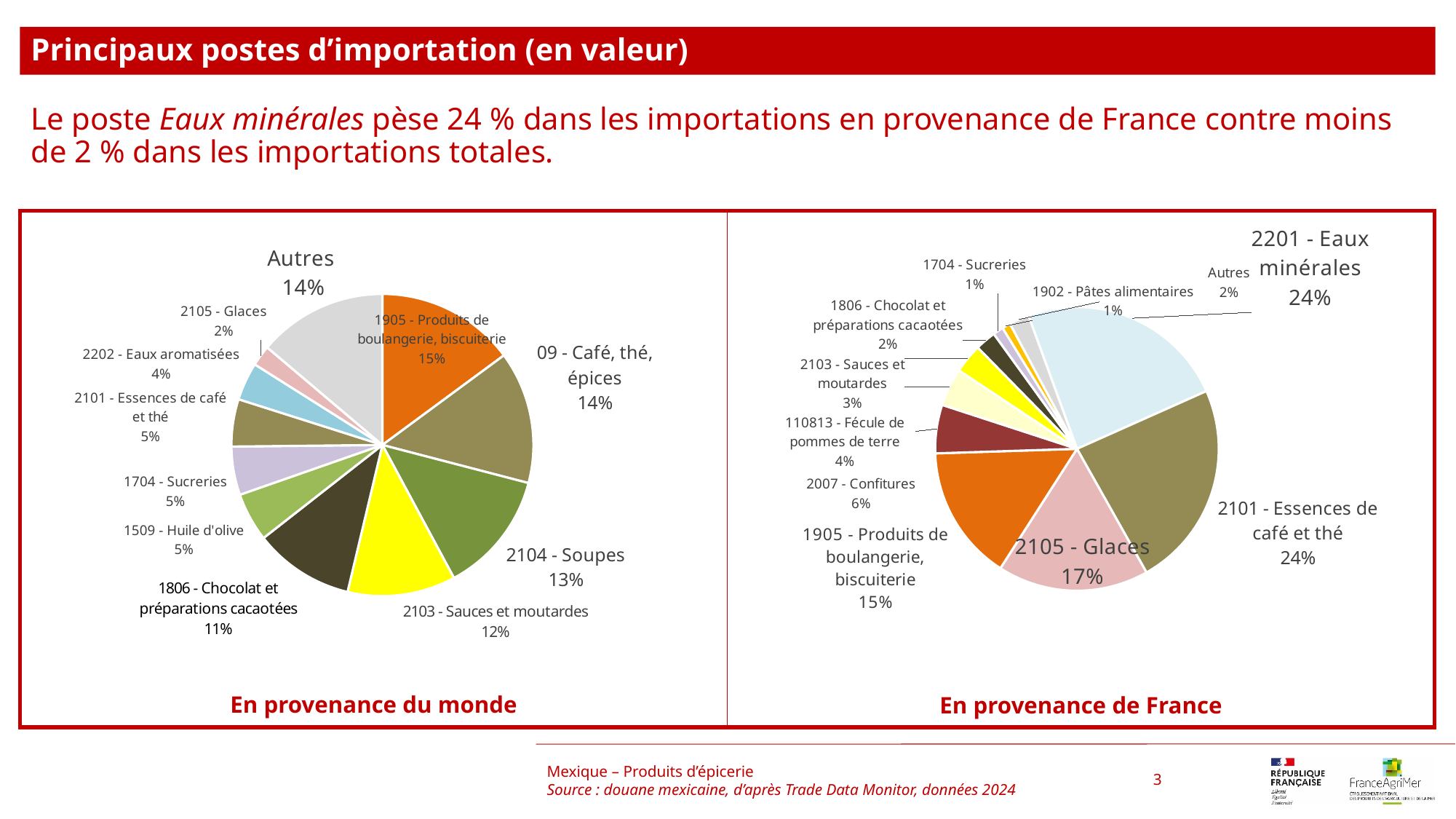
In the 'En provenance du monde' chart, which named product category (excluding 'Autres') has the largest share? 1905 - Produits de boulangerie, biscuiterie In the 'En provenance du monde' chart, what is the difference between the shares of '1905 - Produits de boulangerie, biscuiterie' and '2103 - Sauces et moutardes'? 3% What is the title of the chart on the right side of the slide? En provenance de France What kind of chart is the 'En provenance du monde' chart? pie chart In the 'En provenance du monde' chart, what share does '2104 - Soupes' have? 13% In the 'En provenance de France' chart, what share does '2007 - Confitures' have? 6% In the 'En provenance du monde' chart, what share does '1806 - Chocolat et préparations cacaotées' have? 11% How many slices does the 'En provenance du monde' pie chart have? 11 In the 'En provenance de France' chart, which is larger: '2105 - Glaces' or '1905 - Produits de boulangerie, biscuiterie'? 2105 - Glaces In the 'En provenance du monde' chart, which category has the smallest share? 2105 - Glaces In the 'En provenance de France' chart, what share does '2201 - Eaux minérales' have? 24% In the 'En provenance de France' chart, what is the difference between the shares of '2105 - Glaces' and '110813 - Fécule de pommes de terre'? 13%